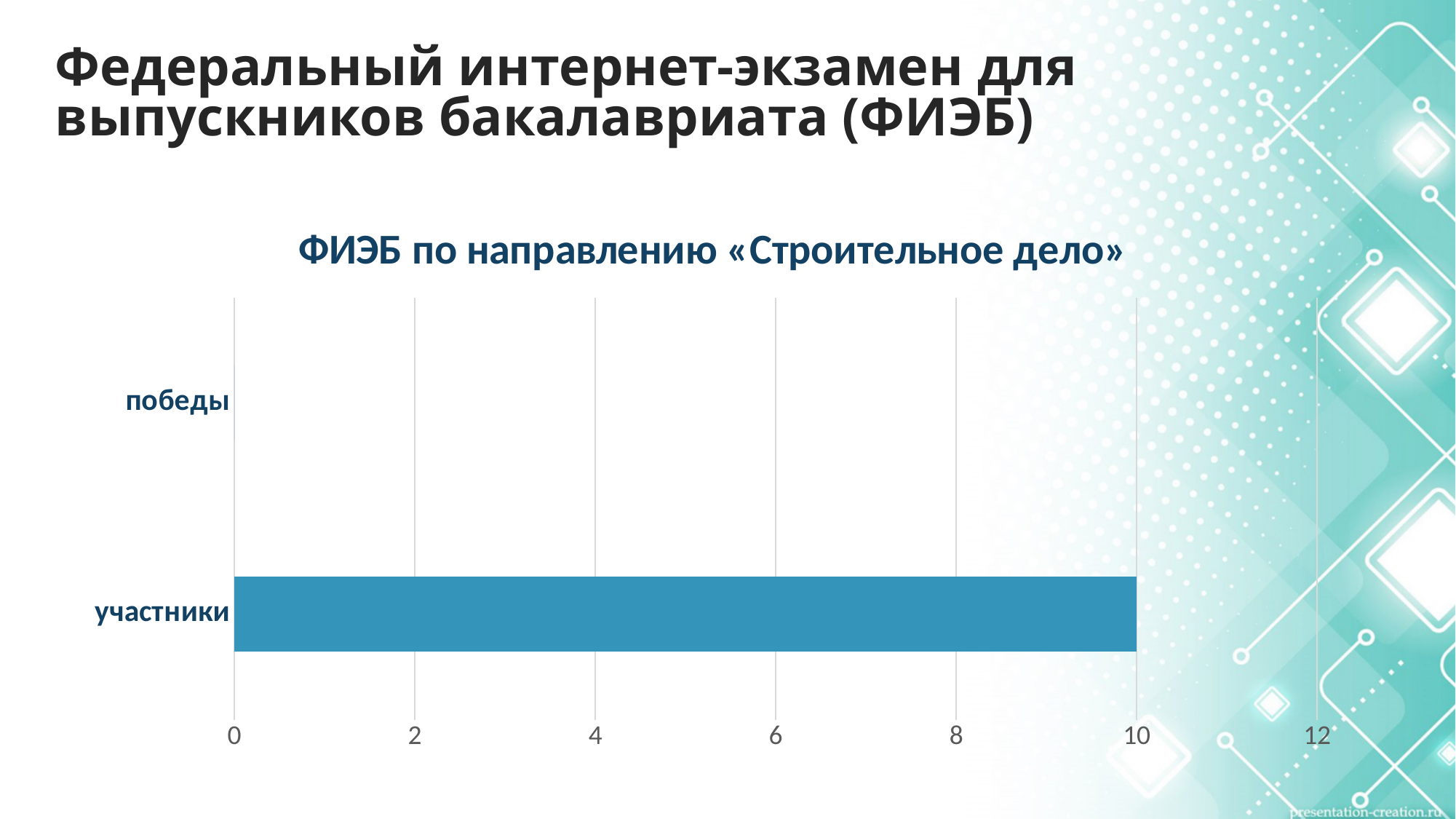
What is the difference between the value for участники and the value for победы? 10 What kind of chart is shown on the slide? bar chart What is the value for победы? 0 What is the highest value shown on the horizontal axis? 12 Which category has the lowest value? победы How many categories are shown on the chart? 2 Is the value for участники greater or less than 8? greater Which category has the highest value? участники What is the value for участники? 10 What is the title of the chart? ФИЭБ по направлению «Строительное дело» Which is larger, the value for участники or the value for победы? участники Is the value for участники greater or less than 12? less